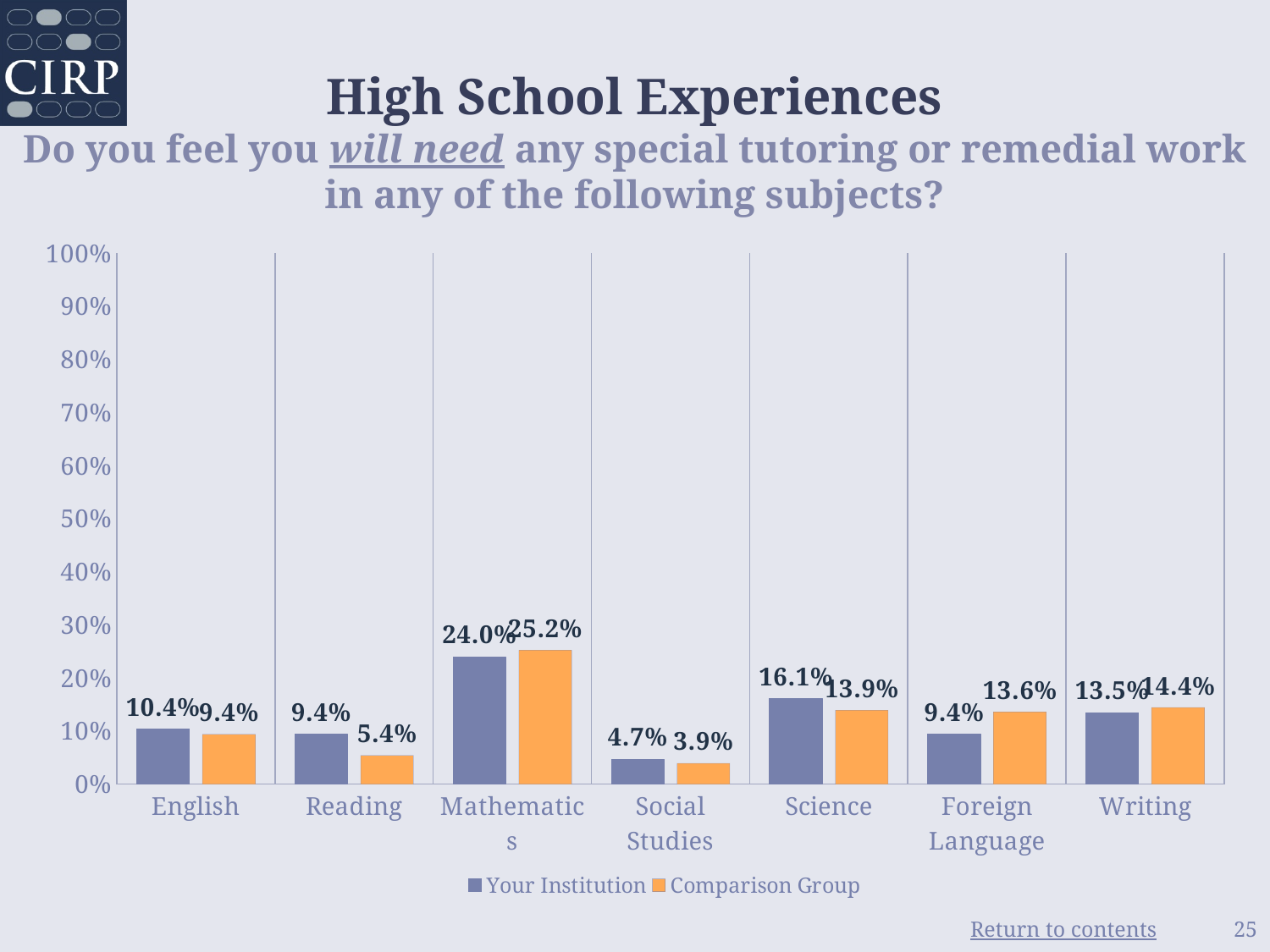
What is the difference between Your Institution and the Comparison Group in Science? 2.2% Which subject has the highest value for the Comparison Group? Mathematics What is the value for Your Institution in Mathematics? 24.0% Which subject has the lowest value for Your Institution? Social Studies Is the value for Your Institution in Mathematics greater or less than 20%? greater How many series does the legend list? 2 What is the value for the Comparison Group in Foreign Language? 13.6% What is the value for the Comparison Group in Reading? 5.4% Which is larger in Foreign Language: Your Institution or the Comparison Group? Comparison Group How many subjects are shown on the x axis? 7 What is the value for Your Institution in Science? 16.1% What kind of chart is shown on the slide? Bar chart